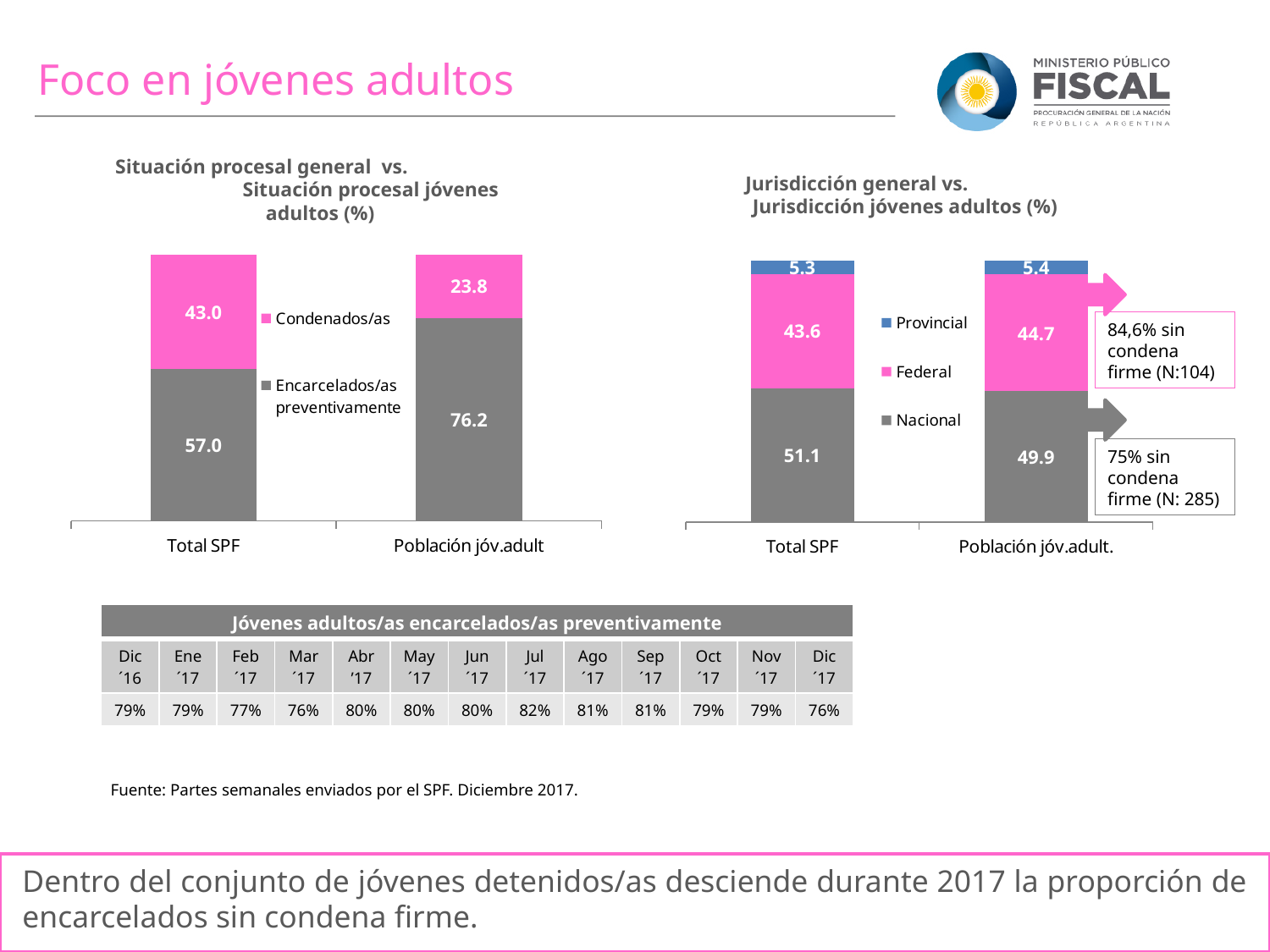
In the left chart (Situación procesal), what is the value for Encarcelados/as preventivamente for Población jóv.adult? 76.2 In the right chart (Jurisdicción), what is the Nacional value for Total SPF? 51.1 In the right chart (Jurisdicción), what is the total of the stacked bar for Población jóv.adult.? 100.0 In the right chart (Jurisdicción), how many series does the legend list? 3 In the right chart (Jurisdicción), what is the Federal value for Población jóv.adult.? 44.7 What type of chart is the left chart (Situación procesal)? Stacked bar chart In the left chart (Situación procesal), which category has the larger Condenados/as value, Total SPF or Población jóv.adult? Total SPF In the left chart (Situación procesal), how many series does the legend list? 2 In the right chart (Jurisdicción), what is the Provincial value for Población jóv.adult.? 5.4 In the left chart (Situación procesal), what is the value for Condenados/as for Total SPF? 43.0 In the right chart (Jurisdicción), which series has the smallest value for Total SPF? Provincial In the left chart (Situación procesal), what is the difference between the Encarcelados/as preventivamente values for Población jóv.adult and Total SPF? 19.2